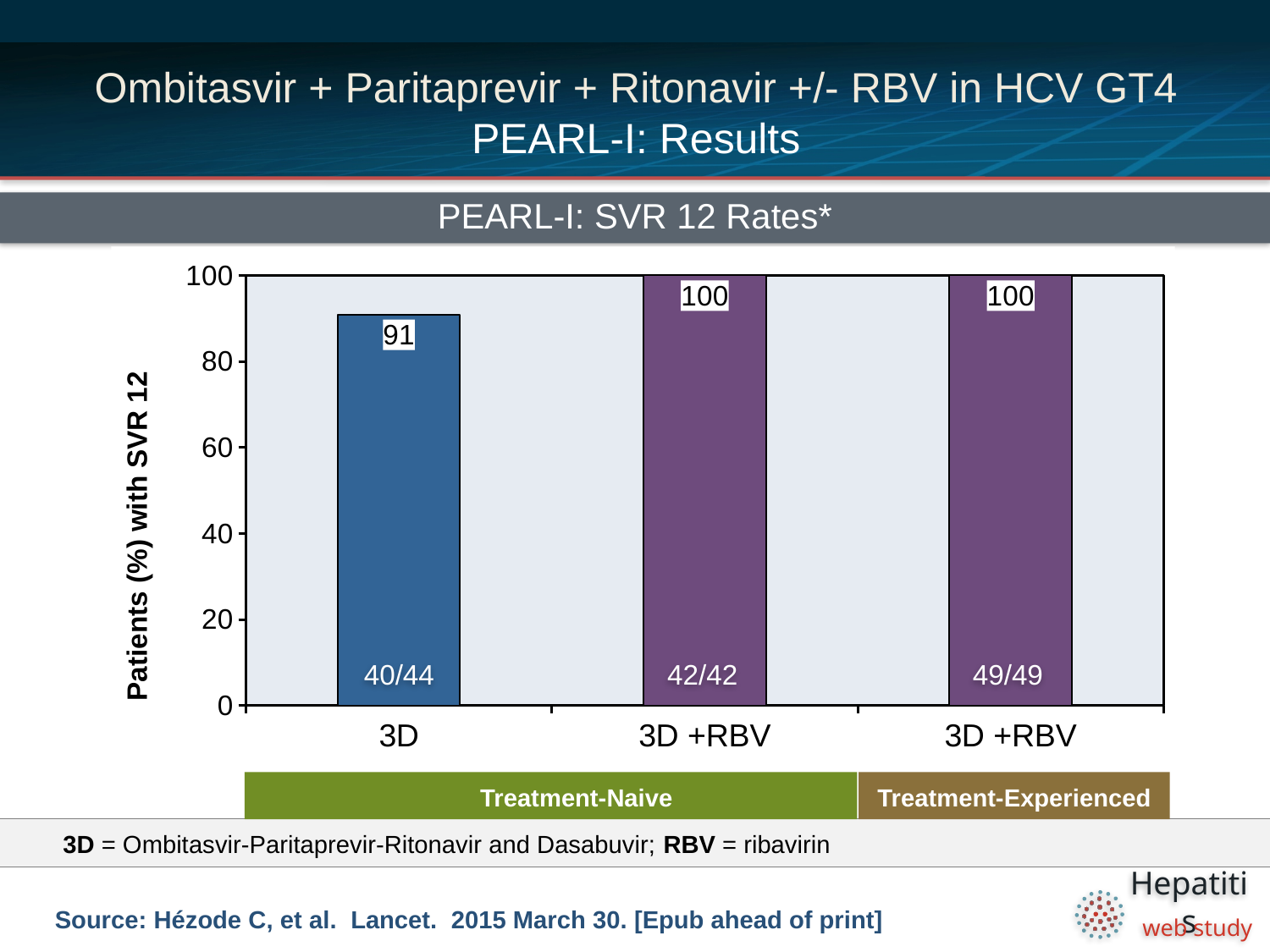
Which arm has the lowest SVR 12 rate? 3D (Treatment-Naive) Is the SVR 12 rate for the 3D arm greater or less than 80? greater Which has a higher SVR 12 rate: the 3D arm or the 3D +RBV treatment-naive arm? 3D +RBV What is the SVR 12 rate for the 3D +RBV arm in treatment-experienced patients? 100 What is the SVR 12 rate for the 3D arm in treatment-naive patients? 91 How many patients achieved SVR 12 out of the total in the 3D treatment-naive arm? 40/44 How many patients achieved SVR 12 out of the total in the 3D +RBV treatment-experienced arm? 49/49 What is the title of the chart? PEARL-I: SVR 12 Rates* What type of chart is shown on the slide? Bar chart How many bars are shown in the chart? 3 What is the label of the y-axis? Patients (%) with SVR 12 What is the difference in SVR 12 rate between the 3D +RBV treatment-naive arm and the 3D arm? 9